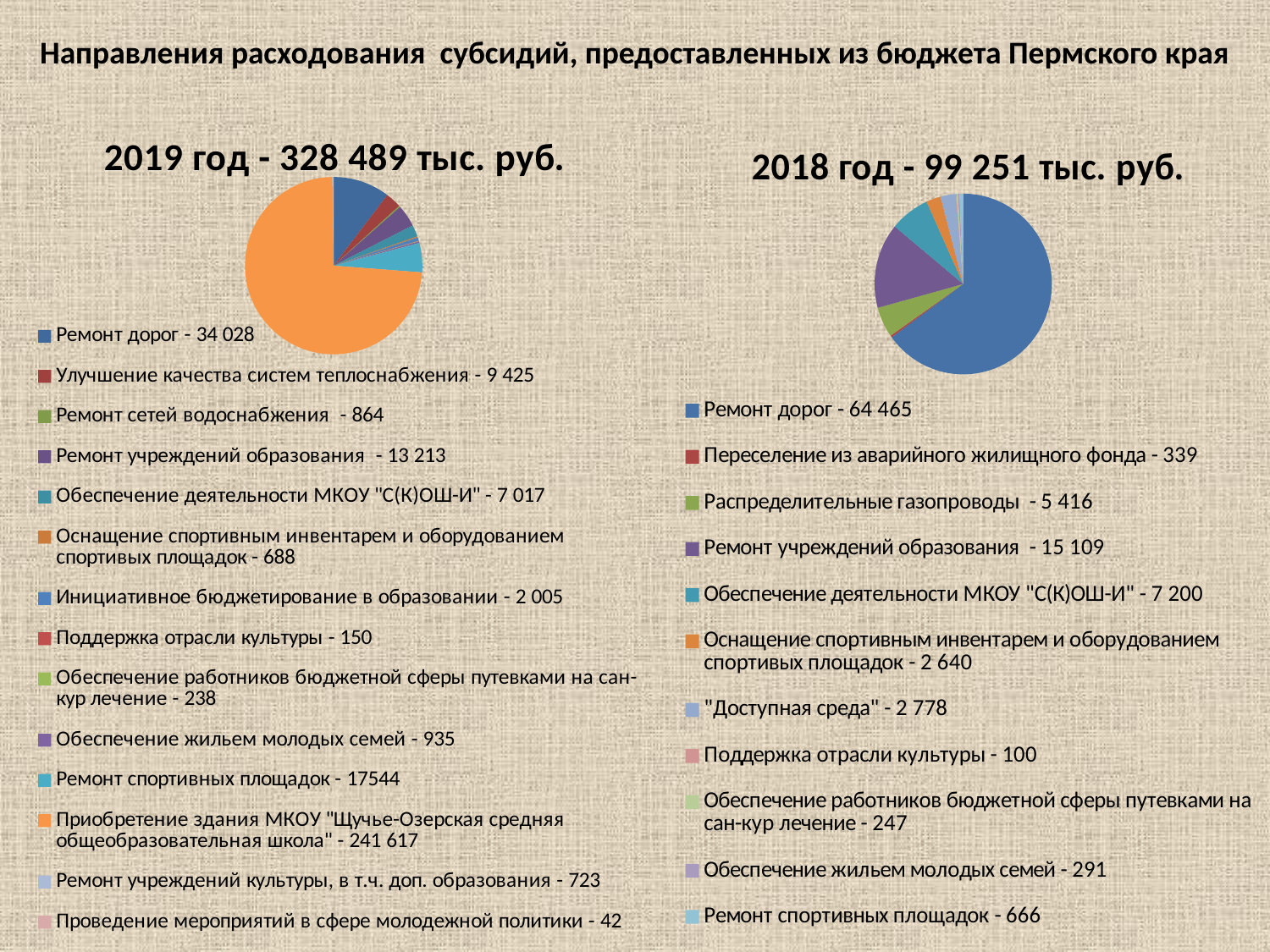
In the 2019 chart, what is the value for "Ремонт дорог"? 34 028 What total amount is stated in the title of the 2018 chart? 99 251 тыс. руб. What is the difference between "Ремонт дорог" in the 2018 chart and "Ремонт дорог" in the 2019 chart? 30 437 How many categories does the legend of the 2019 chart list? 14 How many categories does the legend of the 2018 chart list? 11 In the 2019 chart, what is the value for "Ремонт спортивных площадок"? 17544 In the 2018 chart, which is larger: "Распределительные газопроводы" or "Обеспечение деятельности МКОУ "С(К)ОШ-И""? Обеспечение деятельности МКОУ "С(К)ОШ-И" In the 2019 chart, which category has the smallest value? Проведение мероприятий в сфере молодежной политики What kind of chart is used for the 2019 data on the slide? pie chart In the 2018 chart, what is the value for "Ремонт учреждений образования"? 15 109 In the 2019 chart, which category has the largest value? Приобретение здания МКОУ "Щучье-Озерская средняя общеобразовательная школа" In the 2018 chart, which category has the smallest value? Поддержка отрасли культуры